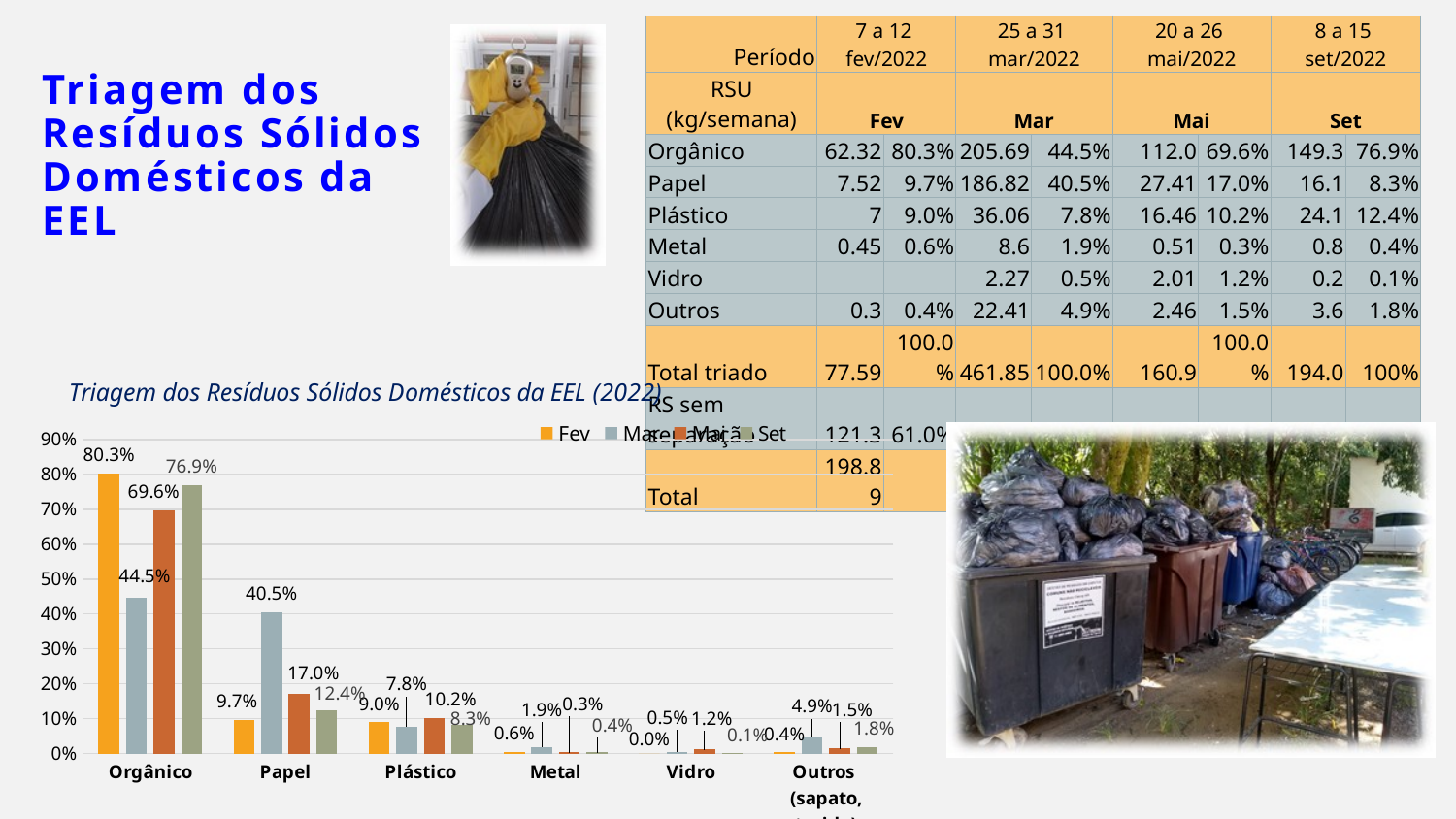
Which is larger for Papel: the Mar value or the Mai value? Mar Which category has the lowest Fev value in the chart? Vidro What is the Mar value for Papel in the chart? 40.5% What is the title of the chart on the slide? Triagem dos Resíduos Sólidos Domésticos da EEL (2022) What is the Fev value for Orgânico in the chart? 80.3% How many series does the chart's legend list? 4 What is the Set value for Plástico in the chart? 8.3% Is the Set value for Orgânico greater or less than 70%? greater Which category has the highest Fev value in the chart? Orgânico What is the difference between the Fev and Mar values for Orgânico? 35.8% How many categories are shown on the x axis of the chart? 6 What type of chart is shown on the slide? bar chart